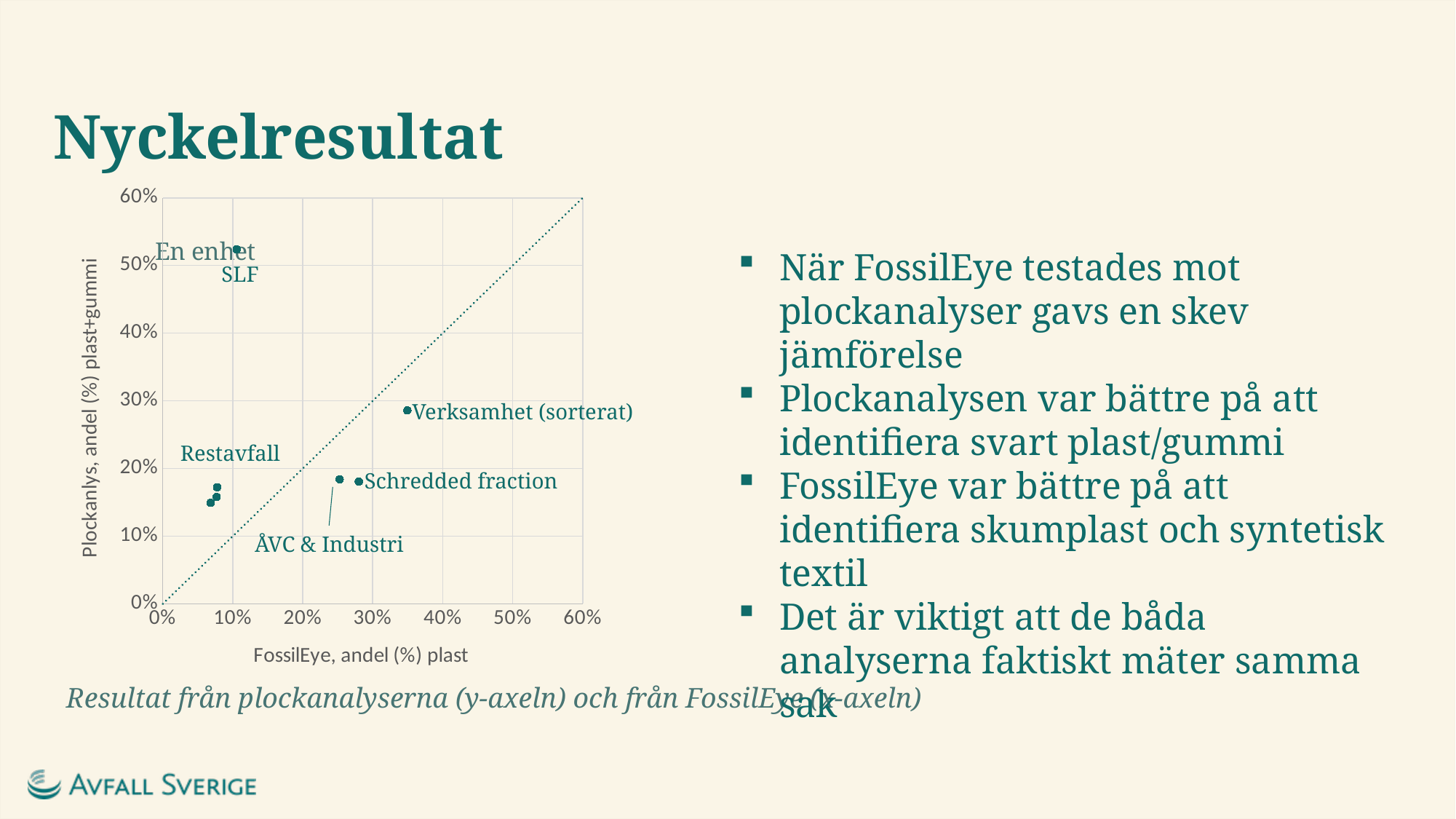
What is the maximum value shown on the y axis of the chart? 60% Is the y-axis value (Plockanlys) for En enhet SLF greater or less than 40%? greater Are the x-axis values (FossilEye) for the Restavfall points greater or less than 10%? less Which has the higher Plockanlys (y-axis) value, En enhet SLF or Verksamhet (sorterat)? En enhet SLF Is the x-axis value (FossilEye) for Schredded fraction greater or less than 20%? greater What is the title of the x axis of the chart? FossilEye, andel (%) plast How many labeled groups of points are shown in the chart? 5 Which labeled point has the highest value on the x axis (FossilEye, andel (%) plast)? Verksamhet (sorterat) What kind of chart is shown on the slide? scatter chart Which labeled point has the highest value on the y axis (Plockanlys, andel (%) plast+gummi)? En enhet SLF